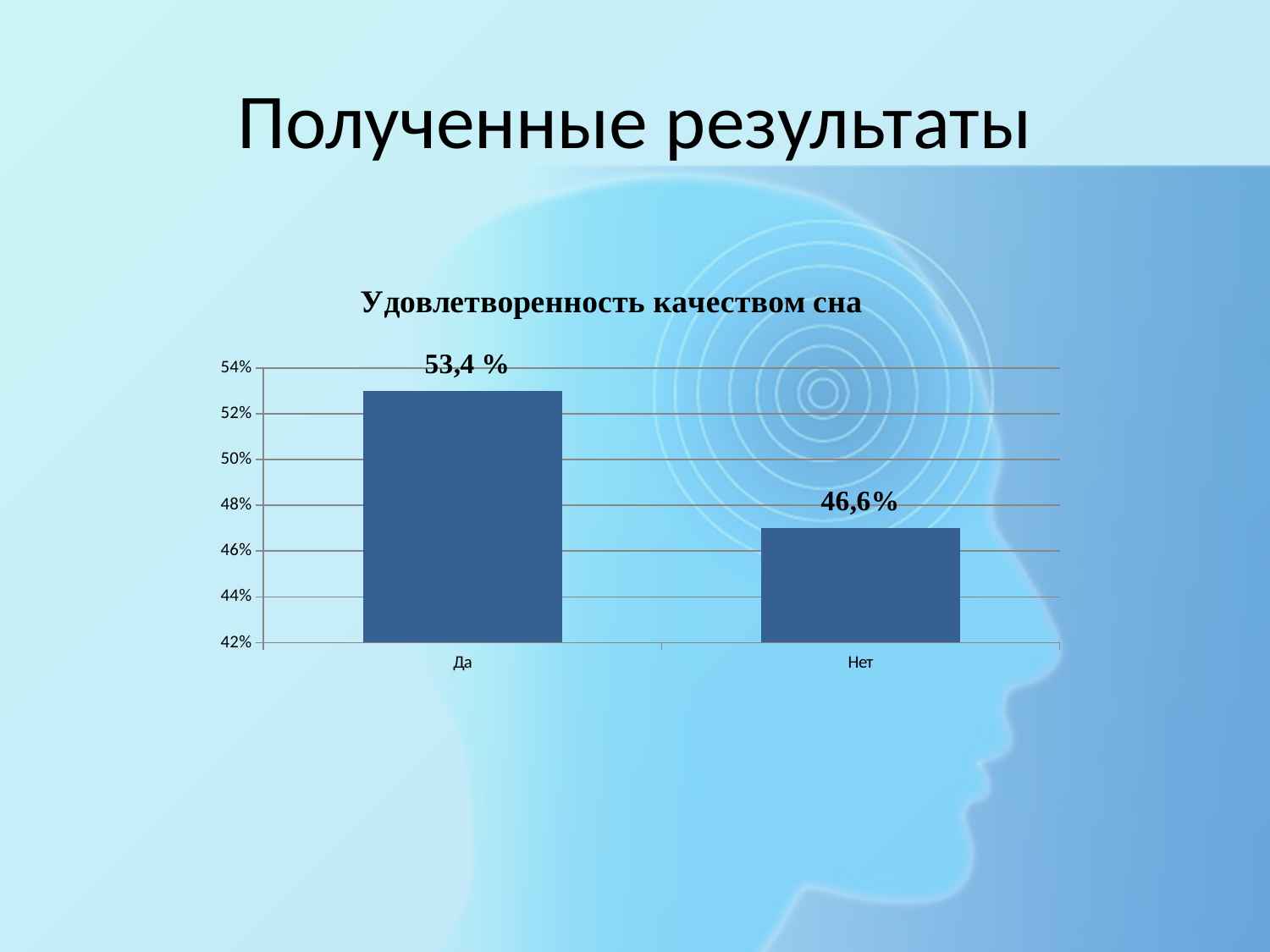
What is the title of the chart? Удовлетворенность качеством сна Which is larger, the value for Да or the value for Нет? Да Which category has the lowest value? Нет Is the value for Да greater or less than 52%? greater What kind of chart is shown on the slide? bar chart What is the value for Да in the chart? 53,4 % Which category has the highest value? Да Is the value for Нет greater or less than 48%? less What is the value for Нет in the chart? 46,6% Do the values rise or fall from Да to Нет along the x axis? fall What is the difference between the values for Да and Нет? 6,8% How many categories are shown in the chart? 2